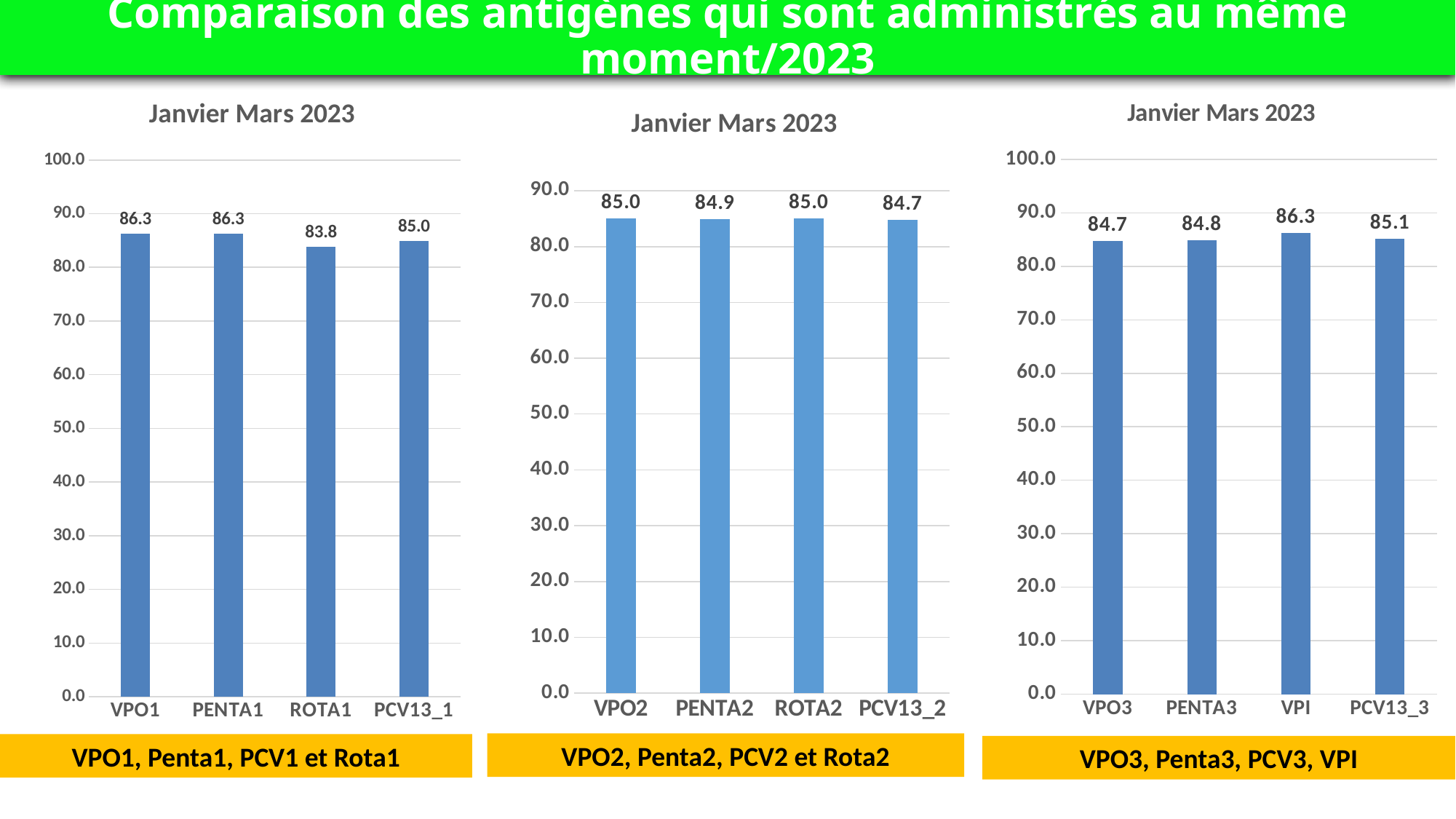
How many categories are shown in the right chart? 4 In the left chart, what is the value for ROTA1? 83.8 In the middle chart, which category has the lowest value? PCV13_2 In the right chart, what is the difference between the values for VPI and VPO3? 1.6 In the right chart, which category has the highest value? VPI What kind of chart is the middle chart? Bar chart In the middle chart, which is larger, the value for VPO2 or the value for PCV13_2? VPO2 What is the title of the left chart? Janvier Mars 2023 In the left chart, what is the difference between the values for VPO1 and ROTA1? 2.5 In the middle chart, what is the value for PENTA2? 84.9 In the left chart, which category has the lowest value? ROTA1 In the right chart, what is the value for PCV13_3? 85.1